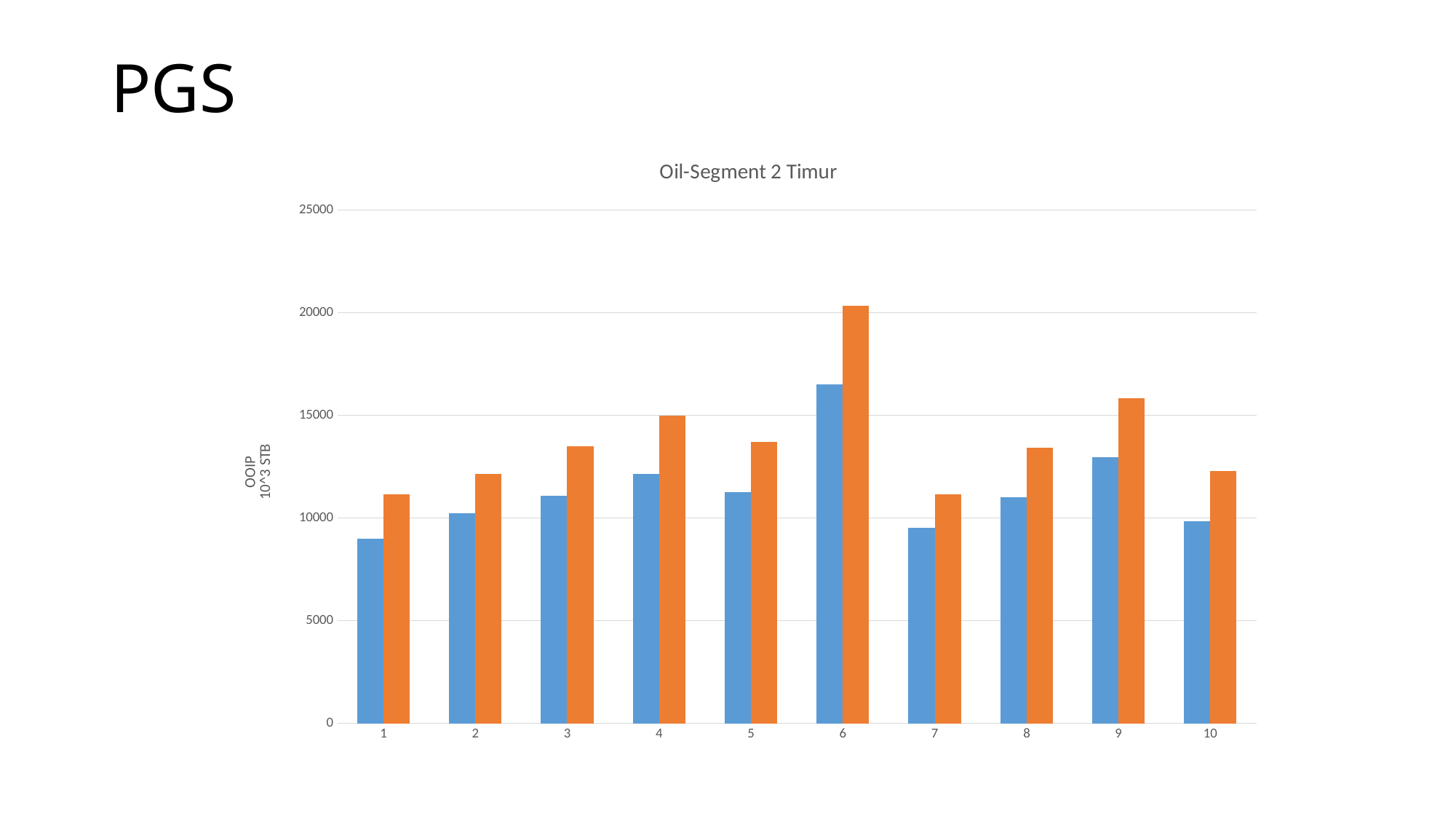
How many categories are shown on the x axis of the chart? 10 Which category has the highest orange bar? 6 Which category has the lowest blue bar? 1 Is the orange bar for category 9 greater or less than 15000? greater Is the blue bar for category 6 greater or less than 15000? greater What kind of chart is shown on the slide? bar chart What is the title of the chart? Oil-Segment 2 Timur What is the label on the vertical axis of the chart? OOIP 10^3 STB Which category has the highest blue bar? 6 Which is larger, the blue bar for category 6 or the blue bar for category 9? category 6 In category 4, which bar is taller, the blue one or the orange one? orange Is the blue bar for category 1 greater or less than 10000? less